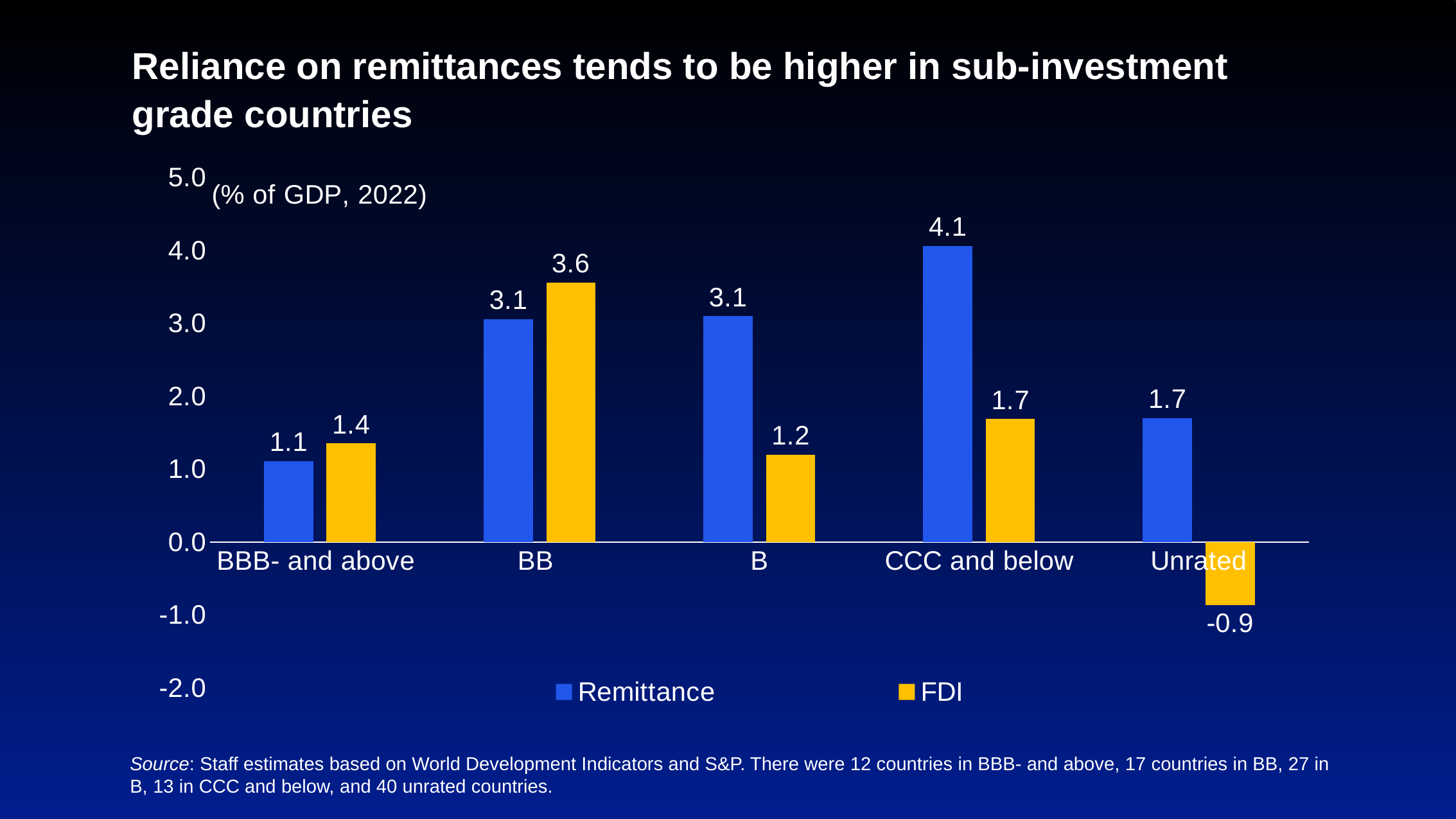
What is the Remittance value for BBB- and above? 1.1 What is the Remittance value for CCC and below? 4.1 What kind of chart is shown on the slide? Bar chart What is the difference between the Remittance and FDI values for CCC and below? 2.4 How many rating categories are shown on the x axis? 5 What is the FDI value for BB? 3.6 What is the FDI value for Unrated? -0.9 How many series does the legend list? 2 Which is larger for BB, Remittance or FDI? FDI Which category has the highest Remittance value? CCC and below What unit is shown in the chart's axis label? % of GDP, 2022 Which category has the lowest FDI value? Unrated